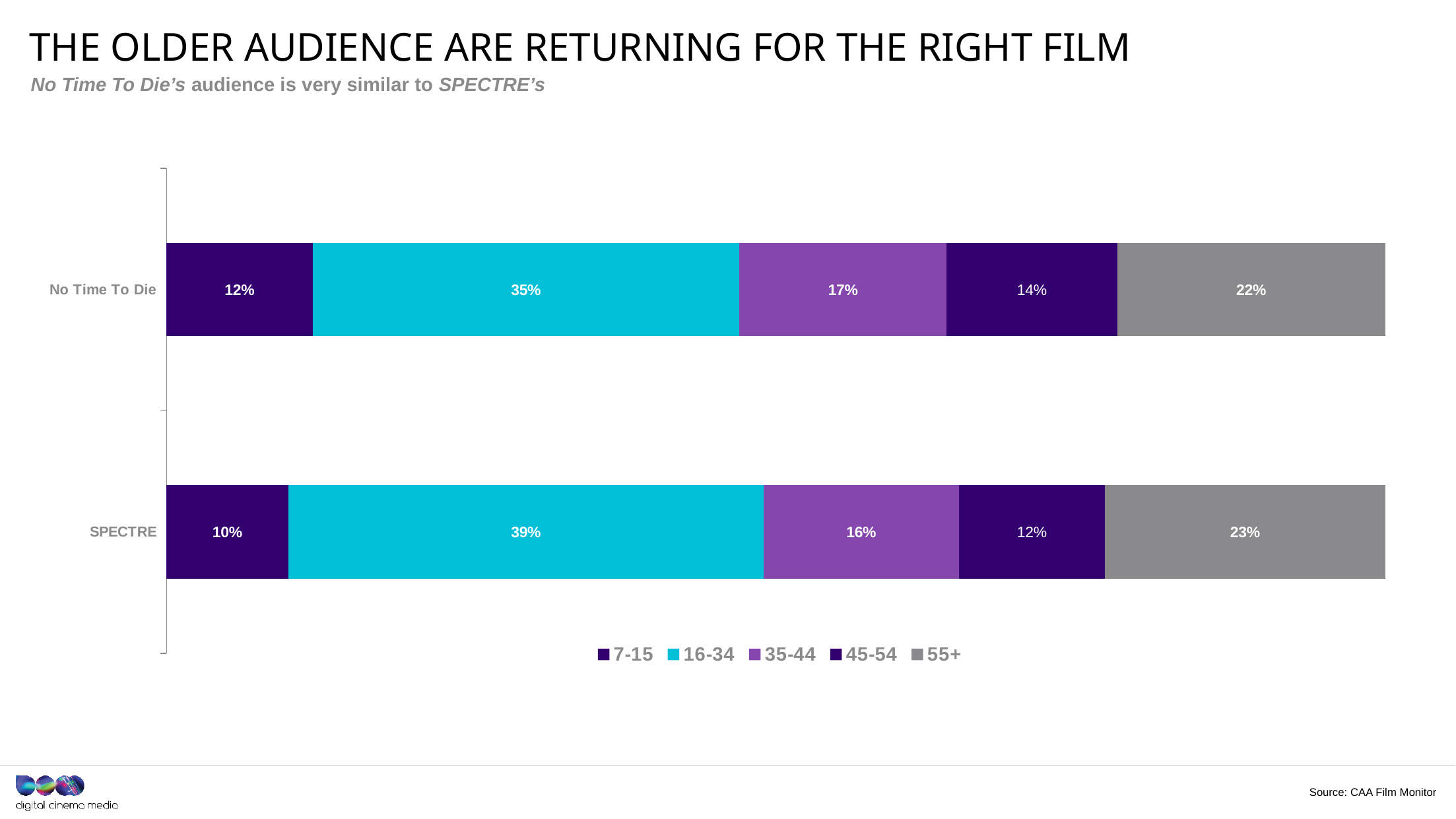
Which film has a larger 45-54 share, No Time To Die or SPECTRE? No Time To Die How many films are shown on the chart? 2 Which age group makes up the largest share of the SPECTRE audience? 16-34 What percentage of the No Time To Die audience is aged 16-34? 35% How many age groups does the legend list? 5 What percentage of the No Time To Die audience is aged 45-54? 14% What percentage of the SPECTRE audience is aged 7-15? 10% Which age group makes up the smallest share of the No Time To Die audience? 7-15 What is the difference between the 16-34 share for SPECTRE and for No Time To Die? 4% What type of chart is shown on the slide? Stacked bar chart What is the total of the No Time To Die bar? 100% What percentage of the SPECTRE audience is aged 55+? 23%